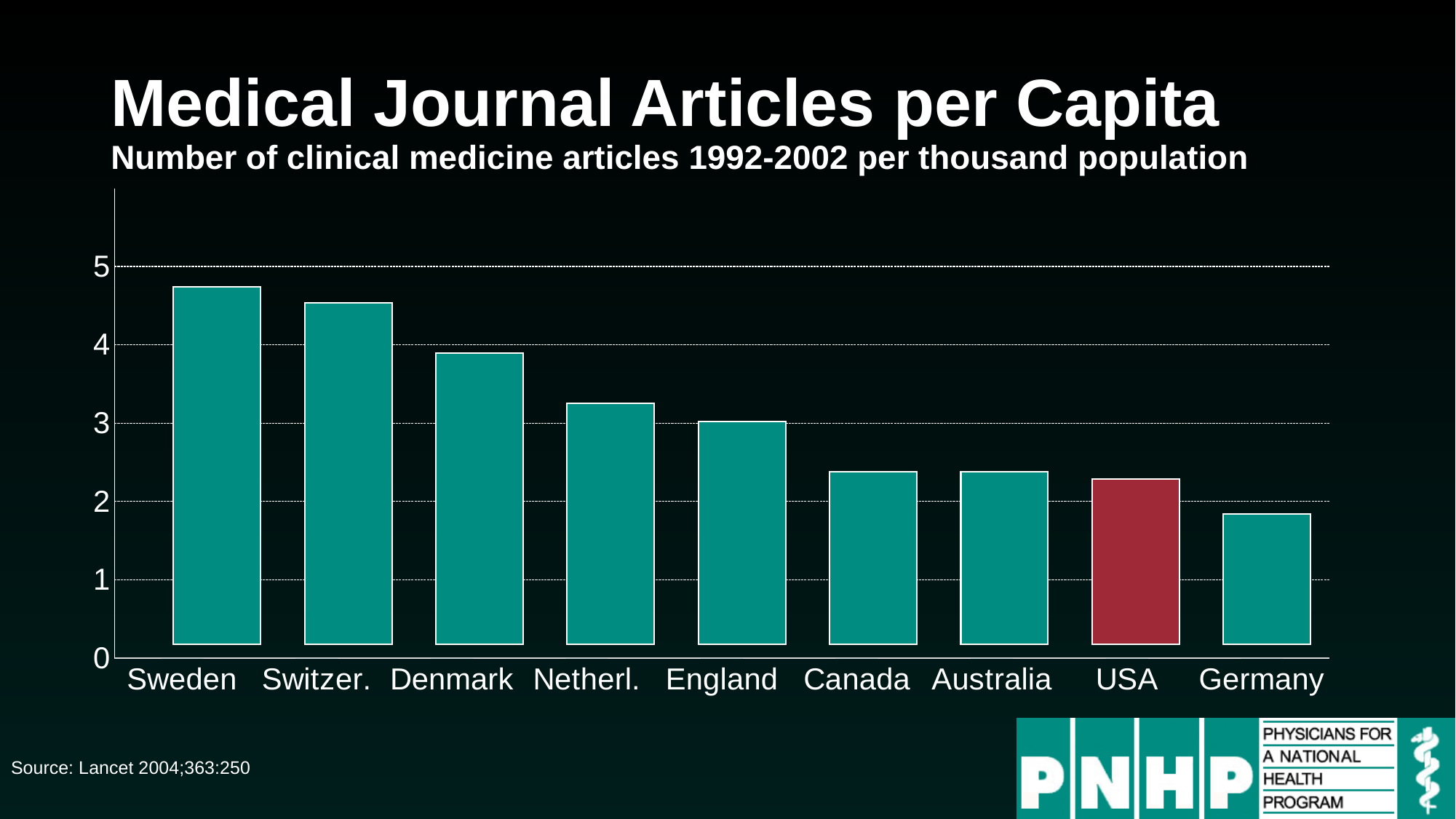
Do the values rise or fall moving from Sweden to Germany along the x axis? fall What kind of chart is shown on the slide? bar chart Is the value for USA greater or less than 2? greater Is the value for Netherl. greater or less than 3? greater Is the value for Sweden greater or less than 4? greater Which has a larger value, Denmark or Canada? Denmark Which country's bar is shown in a different colour (red) from the others? USA Which country has the highest number of clinical medicine articles per thousand population? Sweden Which country has the lowest number of clinical medicine articles per thousand population? Germany How many countries are shown on the chart? 9